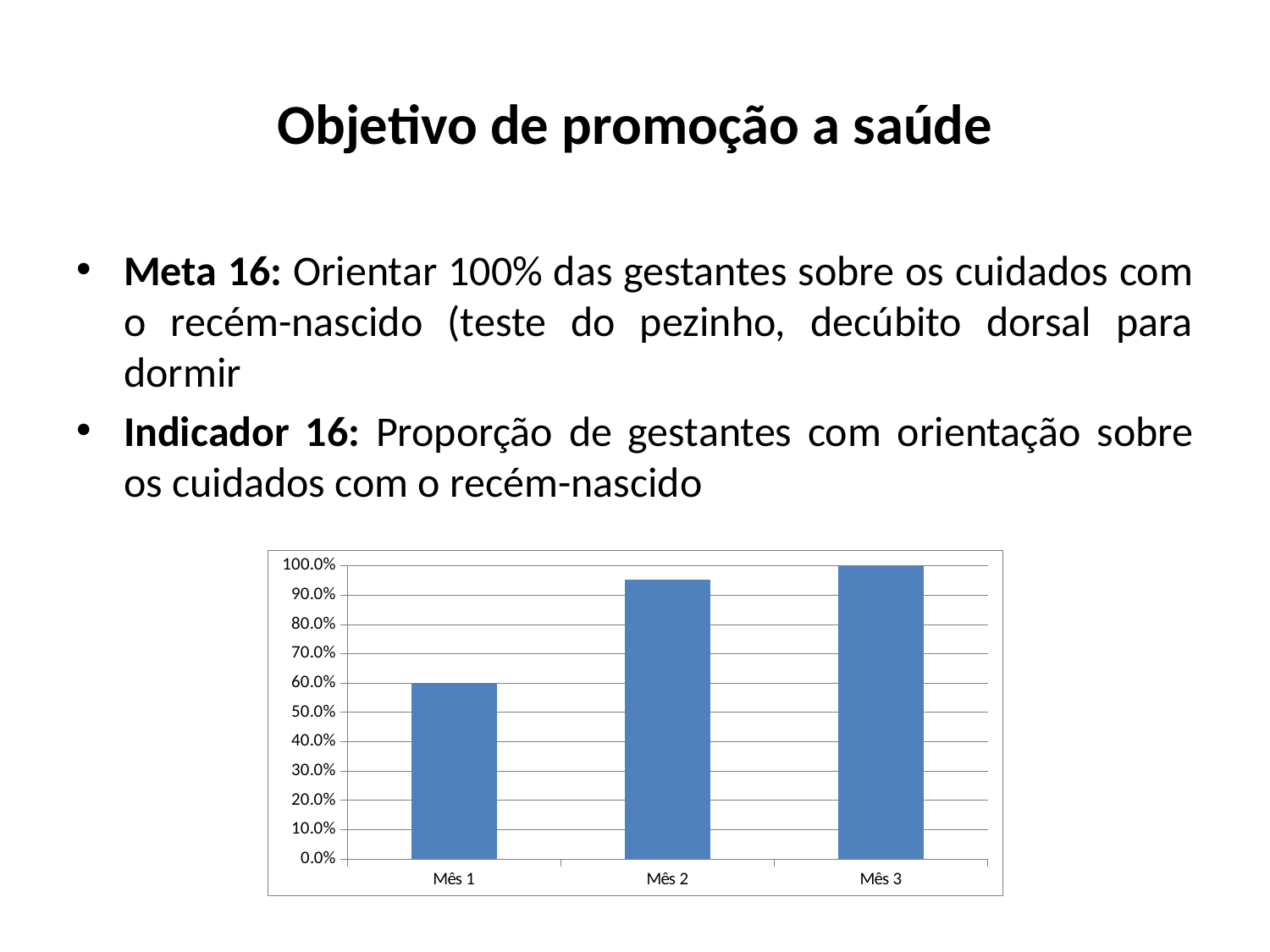
Which is larger, the value for Mês 1 or the value for Mês 2? Mês 2 How many categories are shown on the x axis of the chart? 3 What kind of chart is shown on the slide? bar chart Is the value for Mês 1 greater or less than 70.0%? less Which category has the lowest value in the chart? Mês 1 What is the label of the first category on the x axis of the chart? Mês 1 Do the values rise or fall from Mês 1 to Mês 3? rise Is the value for Mês 2 greater or less than 90.0%? greater Which category has the highest value in the chart? Mês 3 What is the value for Mês 3 in the chart? 100.0%